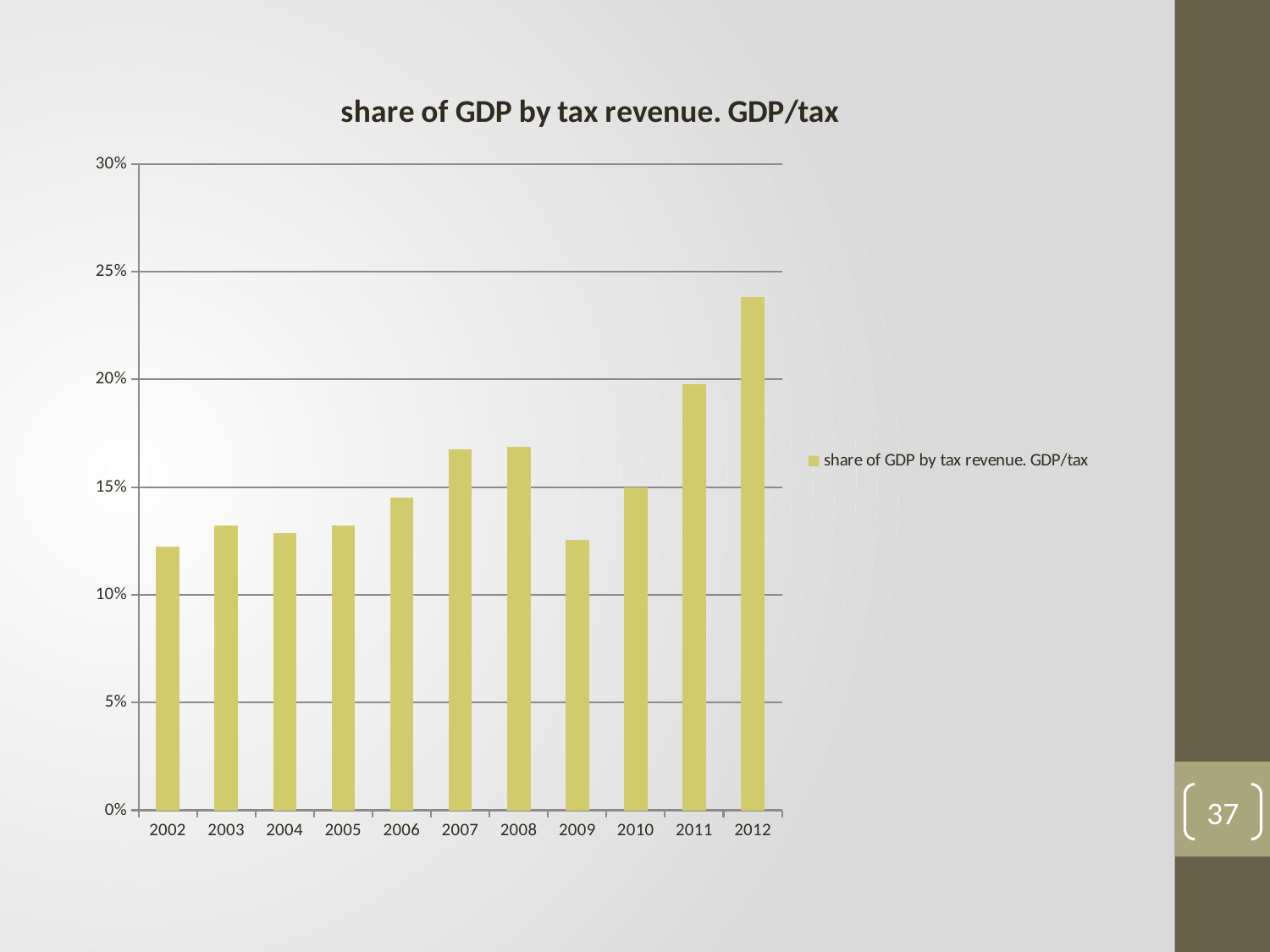
How many series does the legend list? 1 Is the value for 2007 greater or less than 15%? greater Is the value for 2009 greater or less than 15%? less What is the title of the chart? share of GDP by tax revenue. GDP/tax How many years are shown on the x axis? 11 Is the value for 2002 greater or less than 10%? greater Which is larger, the value for 2008 or the value for 2009? 2008 Do the values generally rise or fall from 2002 to 2012? rise Which year has the highest share of GDP by tax revenue? 2012 What kind of chart is shown on the slide? bar chart